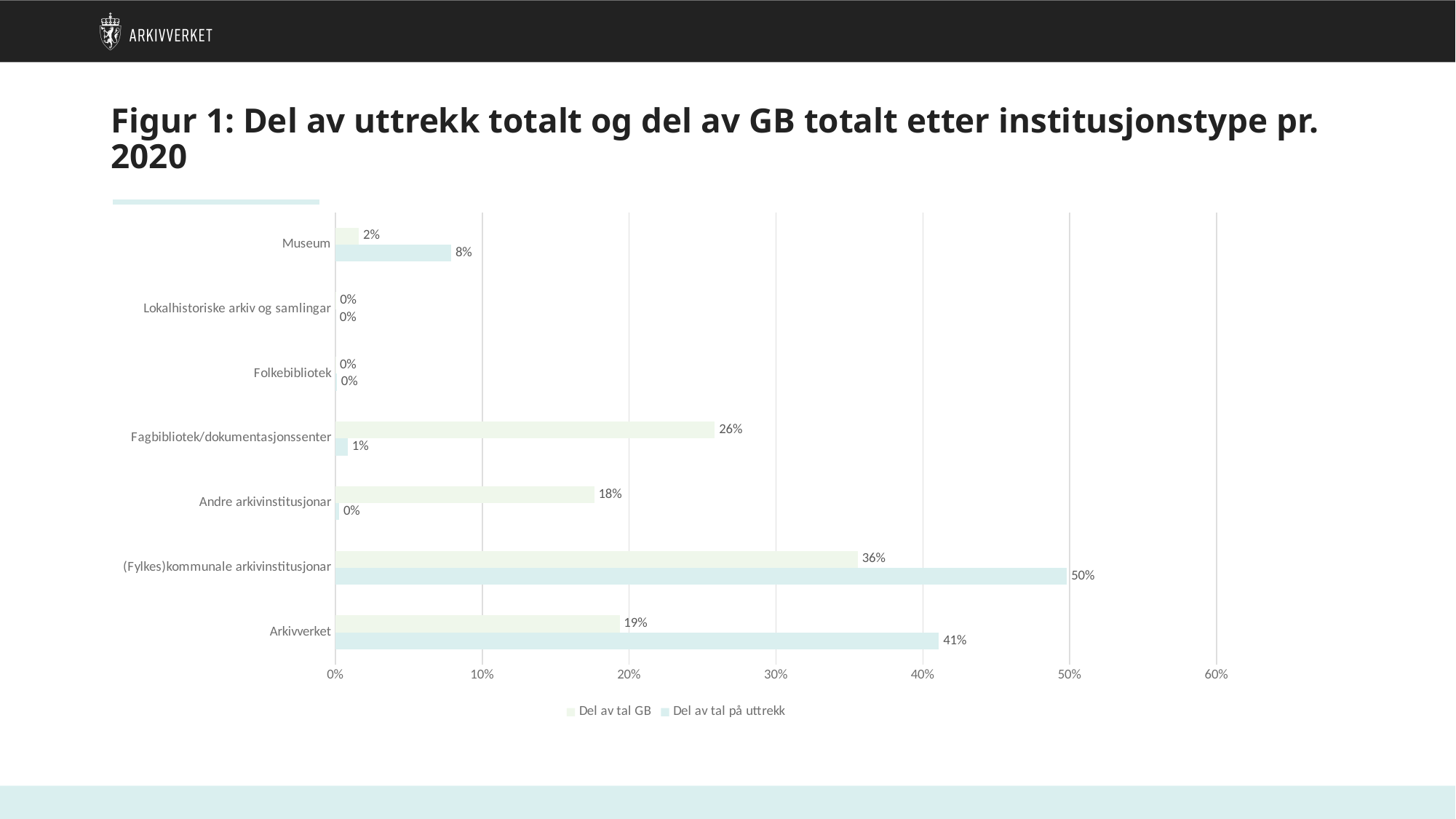
What is the value of 'Del av tal på uttrekk' for Arkivverket? 41% What is the value of 'Del av tal GB' for Fagbibliotek/dokumentasjonssenter? 26% Is the value of 'Del av tal på uttrekk' for Arkivverket greater or less than 30%? greater What is the difference between 'Del av tal på uttrekk' and 'Del av tal GB' for (Fylkes)kommunale arkivinstitusjonar? 14% What is the value of 'Del av tal GB' for Museum? 2% What kind of chart is shown on the slide? Bar chart How many categories are shown on the chart? 7 How many series does the legend list? 2 What is the difference between 'Del av tal på uttrekk' and 'Del av tal GB' for Arkivverket? 22% Which category has the highest value for 'Del av tal GB'? (Fylkes)kommunale arkivinstitusjonar For Fagbibliotek/dokumentasjonssenter, which is larger: 'Del av tal GB' or 'Del av tal på uttrekk'? Del av tal GB Which category has the highest value for 'Del av tal på uttrekk'? (Fylkes)kommunale arkivinstitusjonar